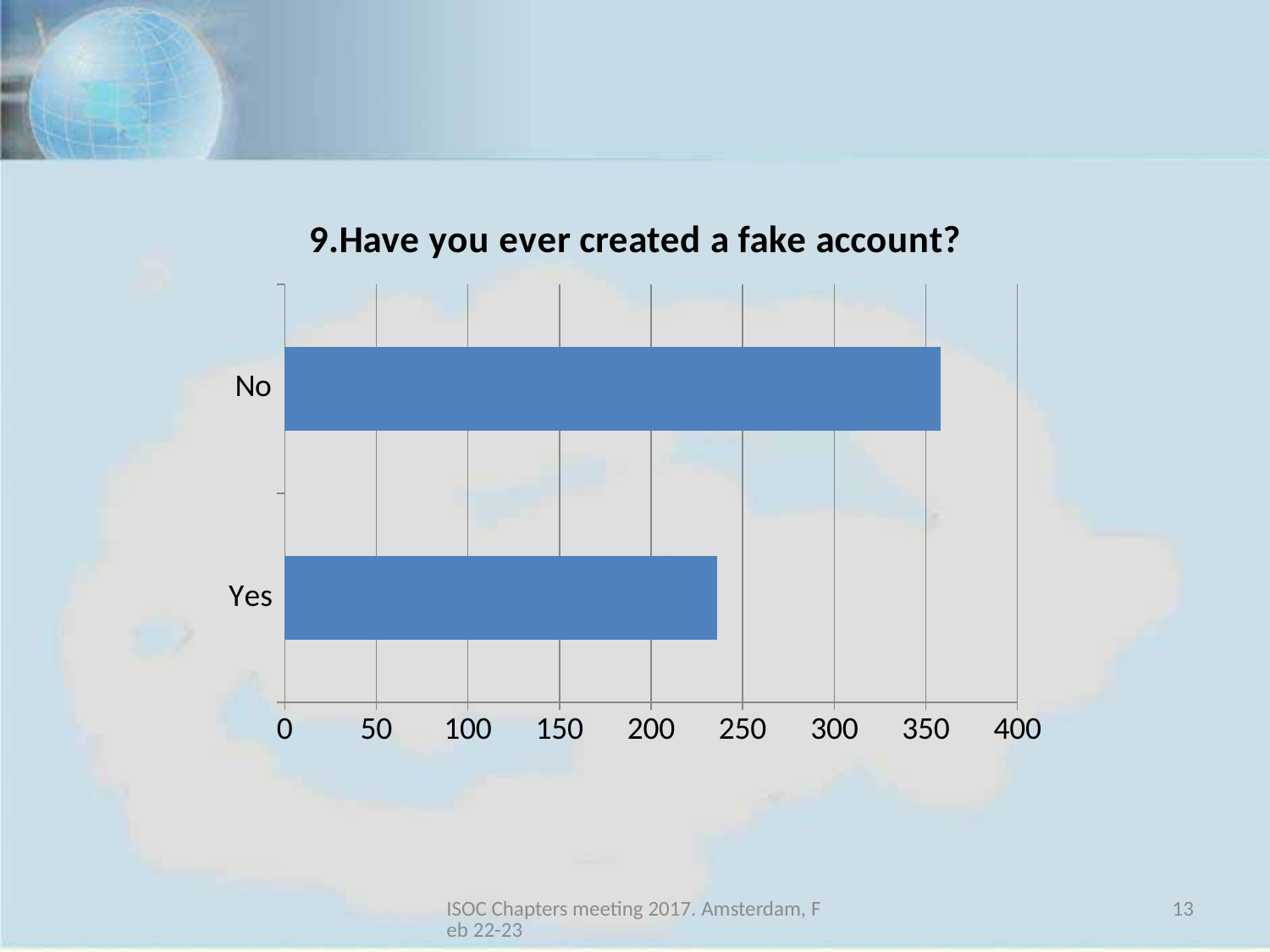
What is the maximum value shown on the horizontal axis? 400 Which category has the highest value? No How many categories does the chart show? 2 Is the value for Yes greater or less than 250? less What is the title of the chart? 9.Have you ever created a fake account? Which category has the lowest value? Yes Is the value for No greater or less than 300? greater Is the value for No greater or less than 400? less Which is larger, the value for No or the value for Yes? No What kind of chart is shown on the slide? bar chart